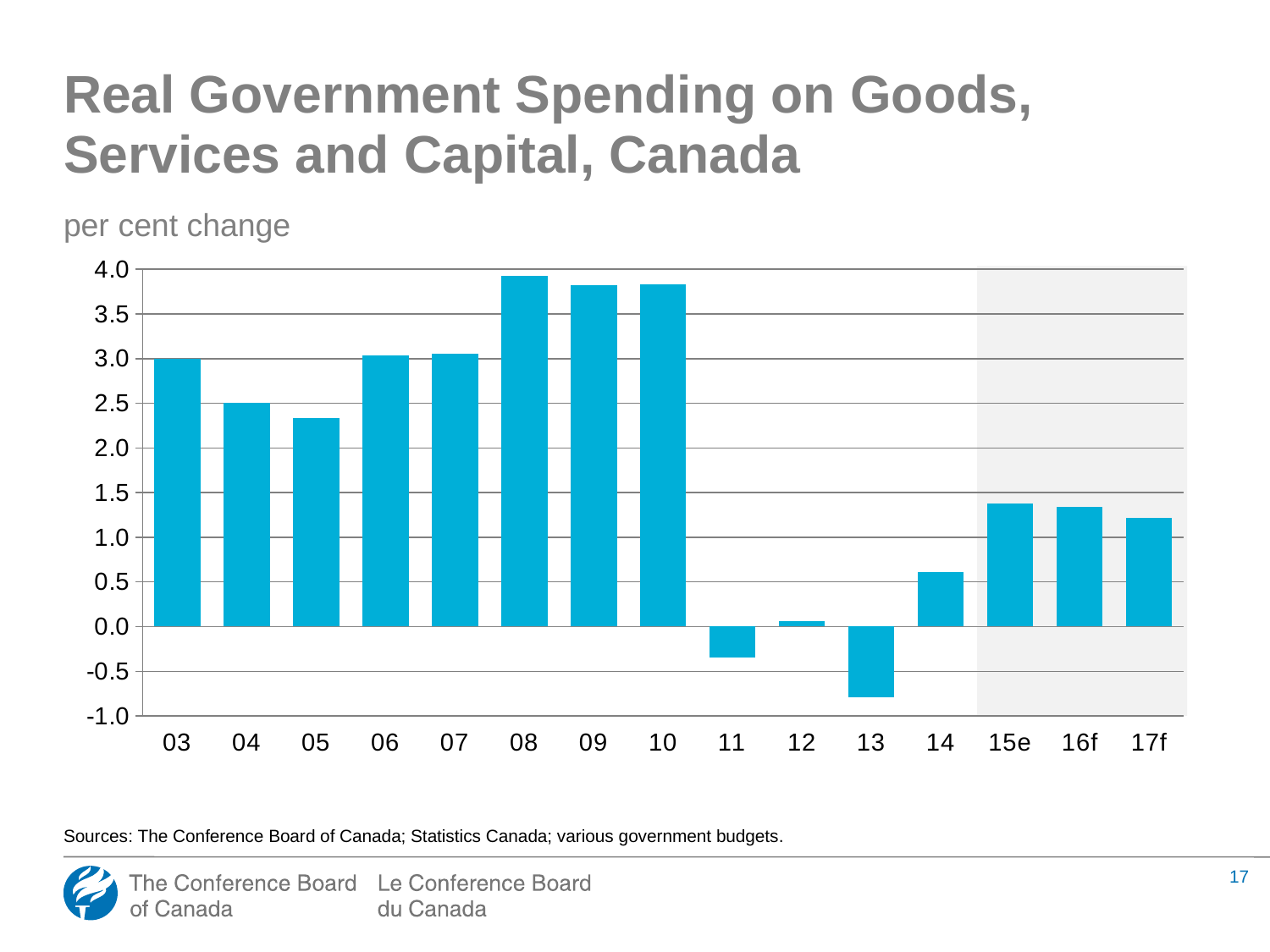
Which year has the lowest per cent change? 13 Is the value for 13 greater or less than -0.5? less How many years (categories) are plotted on the x axis? 15 Is the value for 11 greater or less than 0.0? less Which is larger, the value for 14 or the value for 15e? 15e Is the value for 08 greater or less than 3.5? greater What kind of chart is shown on the slide? bar chart Which year has the highest per cent change? 08 Do the values rise or fall from 15e to 17f? fall What unit is the chart measured in, according to the subtitle? per cent change Which is larger, the value for 03 or the value for 04? 03